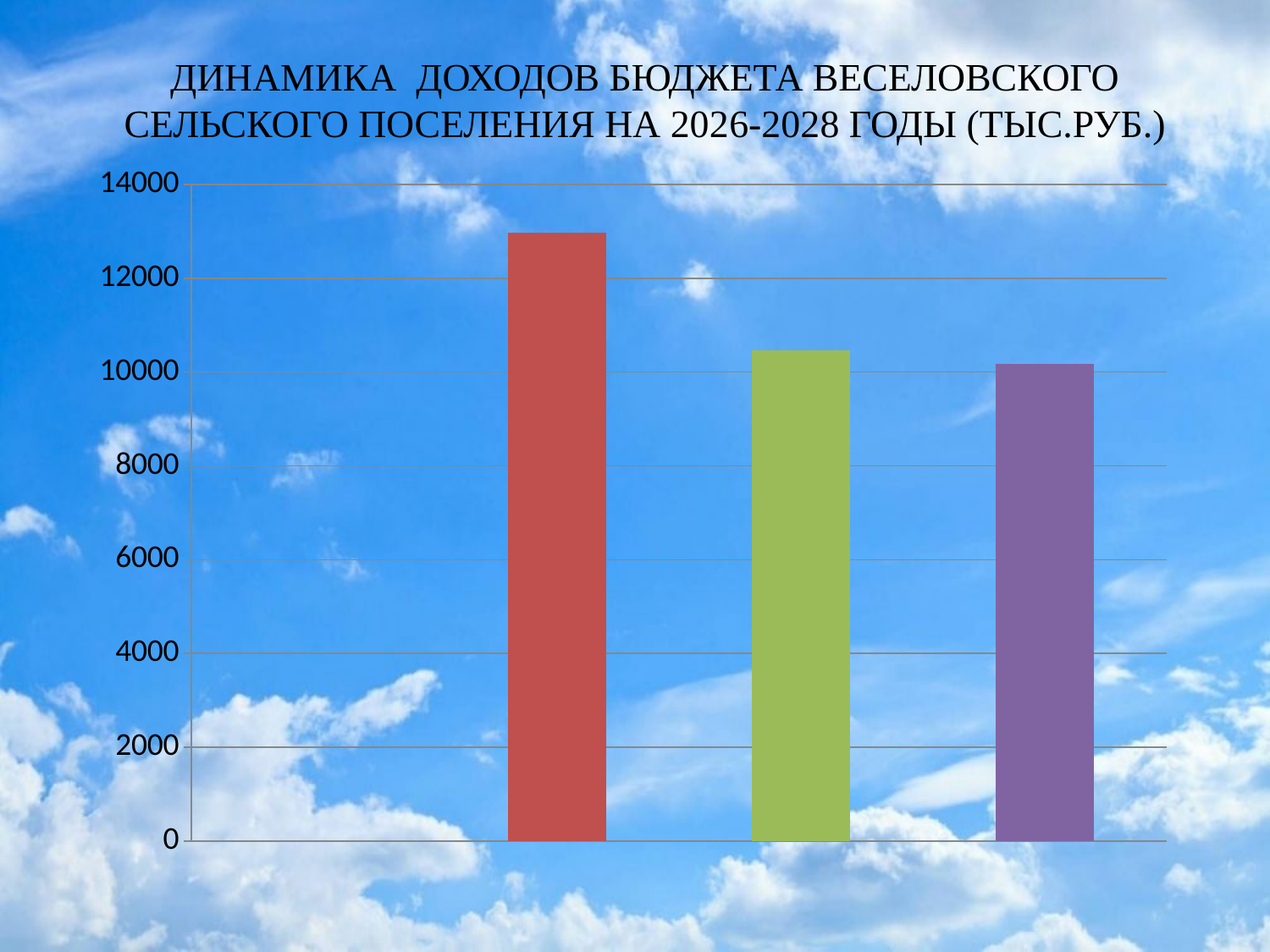
Do the bar values rise or fall from left to right across the chart? fall What is the highest value shown on the vertical axis? 14000 Is the value of the third (purple) bar greater or less than 8000? greater Is the value of the first (red) bar greater or less than 14000? less In what units are the values in the chart expressed, according to the title? тыс. руб. How many bars are plotted in the chart? 3 Which is larger, the first (red) bar or the second (green) bar? the first (red) bar What kind of chart is shown on the slide? bar chart Is the value of the second (green) bar greater or less than 12000? less Which bar is the highest in the chart? the first (red) bar